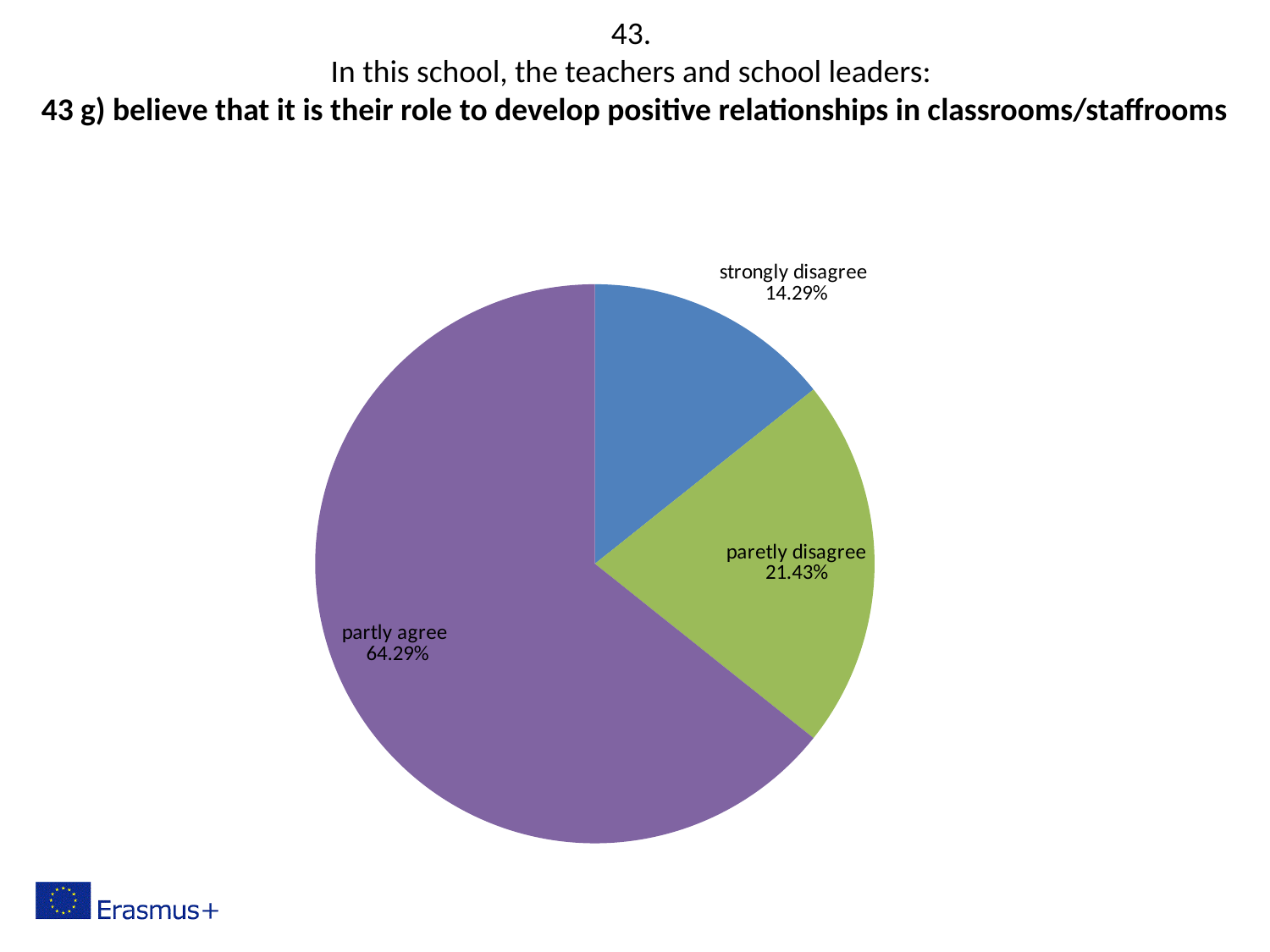
What percentage of respondents chose "paretly disagree"? 21.43% How many slices does the pie chart have? 3 What percentage of respondents chose "partly agree"? 64.29% What is the difference in percentage points between "paretly disagree" and "strongly disagree"? 7.14 What is the difference in percentage points between "partly agree" and "paretly disagree"? 42.86 What percentage of respondents chose "strongly disagree"? 14.29% Which response category has the largest share of the pie? partly agree What colour is the "partly agree" slice? purple Which is larger, the share for "paretly disagree" or the share for "strongly disagree"? paretly disagree What kind of chart is shown on the slide? pie chart What colour is the "strongly disagree" slice? blue Which response category has the smallest share of the pie? strongly disagree